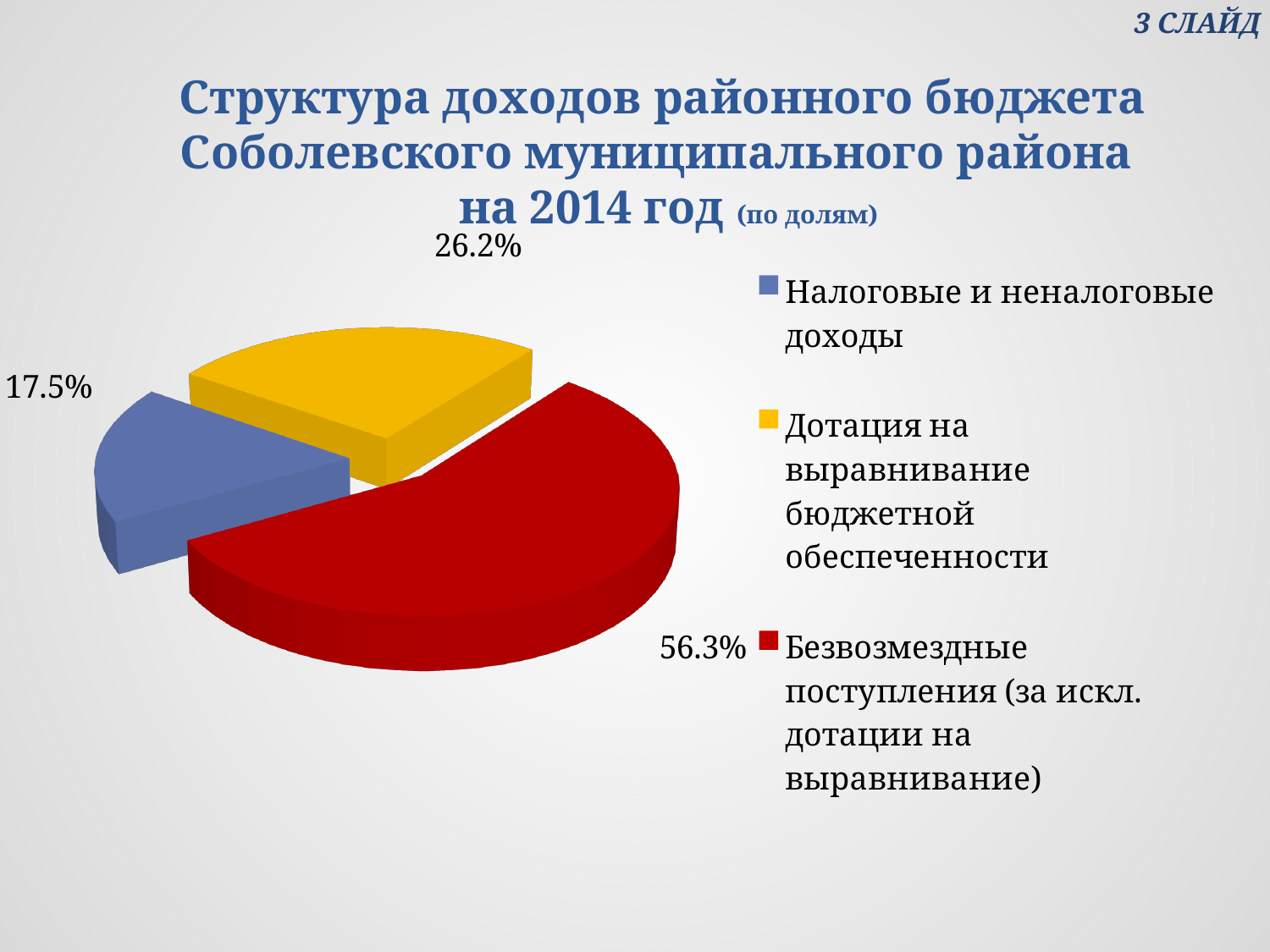
What is the difference in percentage points between the Безвозмездные поступления slice and the Дотация на выравнивание бюджетной обеспеченности slice? 30.1 What is the difference in percentage points between the Дотация на выравнивание бюджетной обеспеченности slice and the Налоговые и неналоговые доходы slice? 8.7 What share of the pie is labelled for Дотация на выравнивание бюджетной обеспеченности? 26.2% Which is larger: the slice for Дотация на выравнивание бюджетной обеспеченности or the slice for Налоговые и неналоговые доходы? Дотация на выравнивание бюджетной обеспеченности What colour is the slice for Безвозмездные поступления (за искл. дотации на выравнивание)? Red Which year does the chart title say the budget income structure refers to? 2014 What share of the pie is labelled for Безвозмездные поступления (за искл. дотации на выравнивание)? 56.3% What kind of chart is shown on the slide? Pie chart What share of the pie is labelled for Налоговые и неналоговые доходы? 17.5% How many slices does the pie chart have? 3 Which category has the largest slice of the pie? Безвозмездные поступления (за искл. дотации на выравнивание) Which category has the smallest slice of the pie? Налоговые и неналоговые доходы